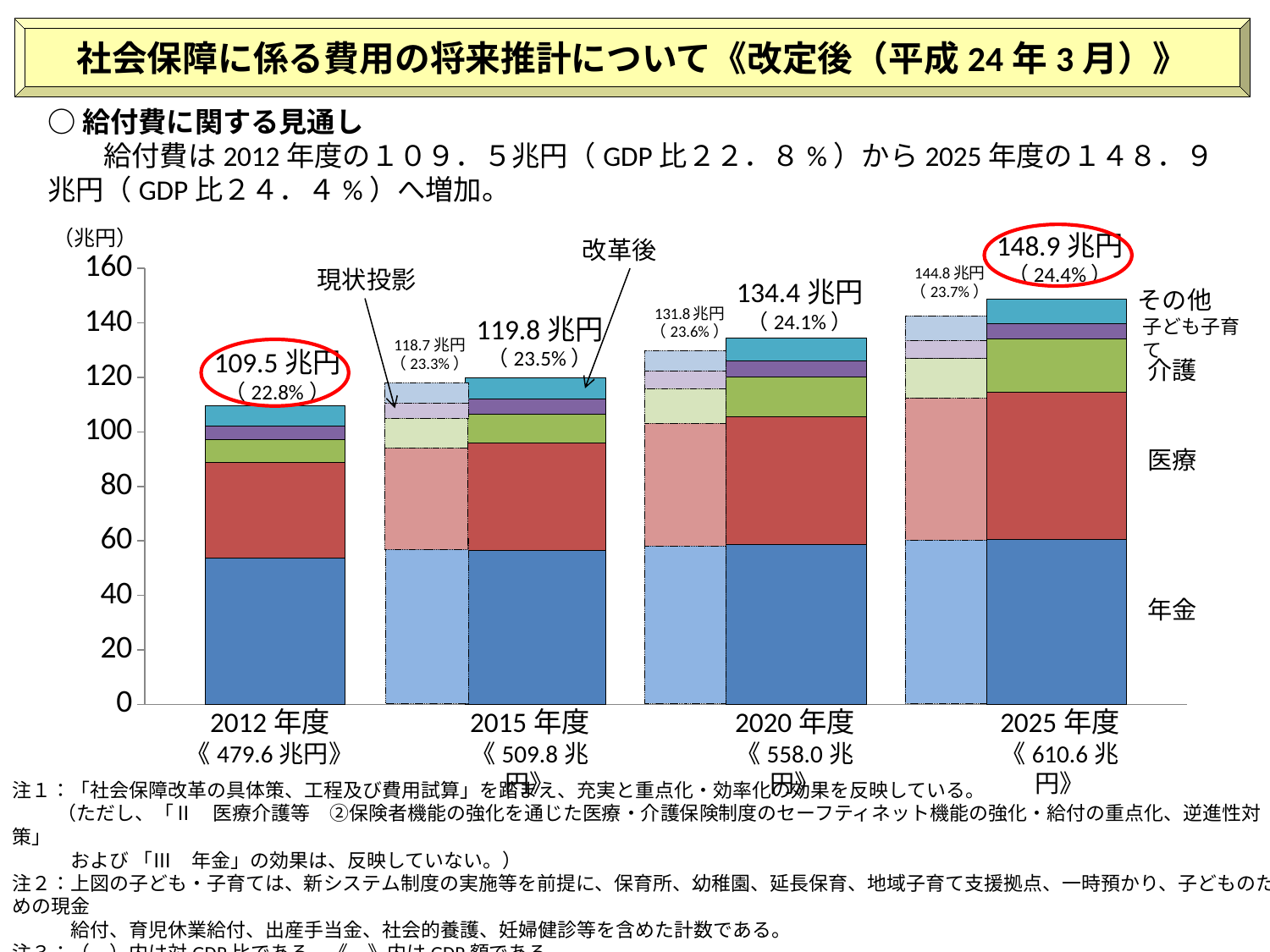
What is the difference between the 改革後 total for 2025年度 (148.9兆円) and the total for 2012年度 (109.5兆円)? 39.4兆円 What GDP ratio is shown in parentheses for the 改革後 bar in 2020年度? 24.1% Which fiscal year has the lowest labelled total benefit cost? 2012年度 How many fiscal years are shown on the x axis? 4 How many cost categories are labelled to the right of the bars? 5 What is the total benefit cost labelled for 2012年度? 109.5兆円 In 2020年度, which bar has the larger total: 現状投影 or 改革後? 改革後 Which fiscal year has the highest labelled total benefit cost? 2025年度 What type of chart is shown on the slide? Stacked bar chart What is the total labelled for the 現状投影 bar in 2015年度? 118.7兆円 What is the total benefit cost labelled for the 改革後 bar in 2025年度? 148.9兆円 Is the 年金 segment of the 2012年度 bar greater or less than 60? less